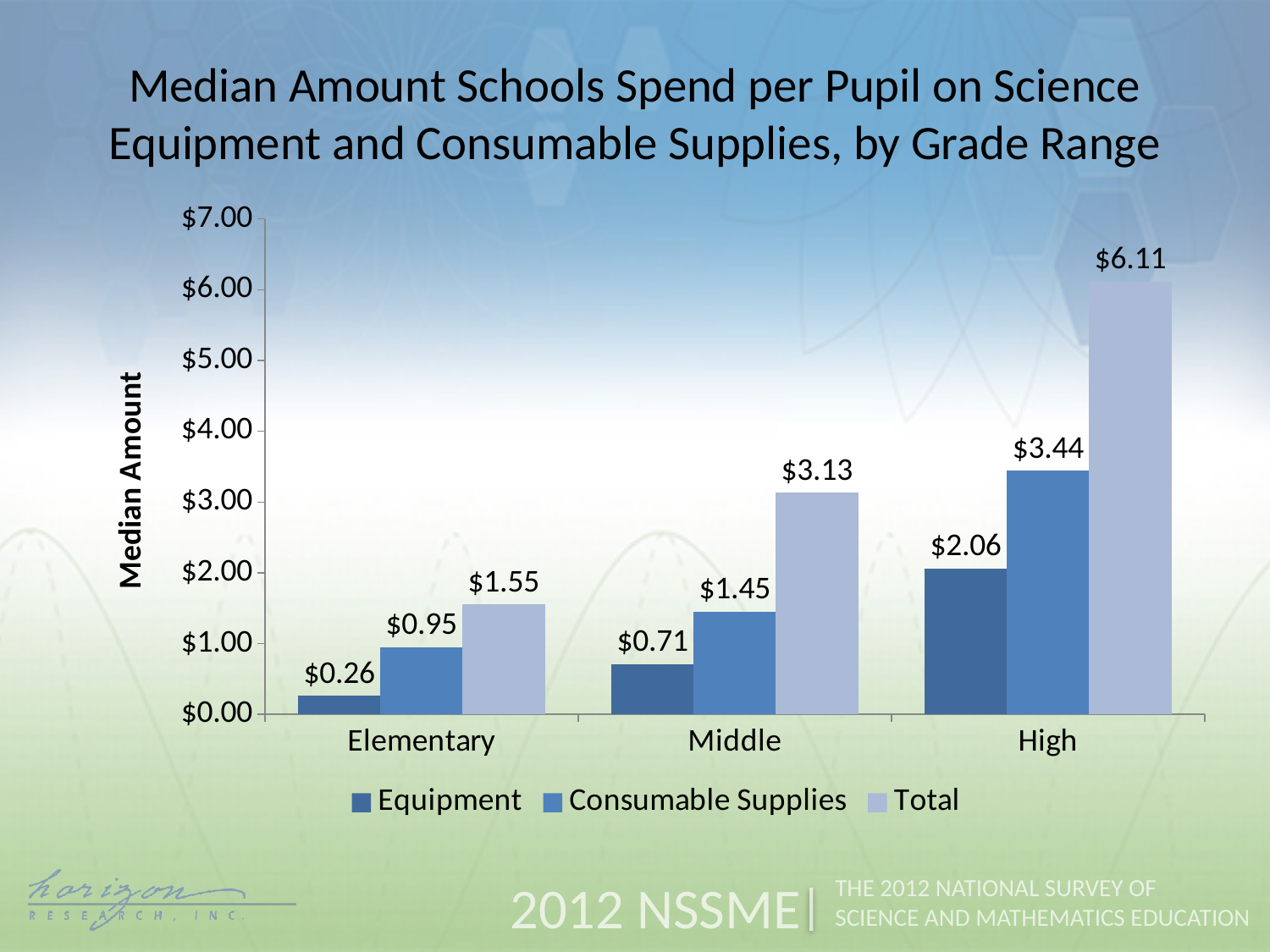
What kind of chart is shown on the slide? Bar chart Which grade range has the lowest Equipment median amount? Elementary What is the Total median amount for High schools? $6.11 What is the median Consumable Supplies amount for Middle schools? $1.45 Which grade range has the highest Total median amount? High What is the median Equipment amount for Elementary schools? $0.26 Is the Total median amount for High schools greater or less than $6.00? greater How many series does the legend list? 3 How many grade ranges are shown on the x axis? 3 Which is larger: the Consumable Supplies amount for High schools or the Total amount for Middle schools? Consumable Supplies for High schools Do the Equipment median amounts rise or fall from Elementary to High? Rise What is the difference between the Total median amount for High schools and for Middle schools? $2.98